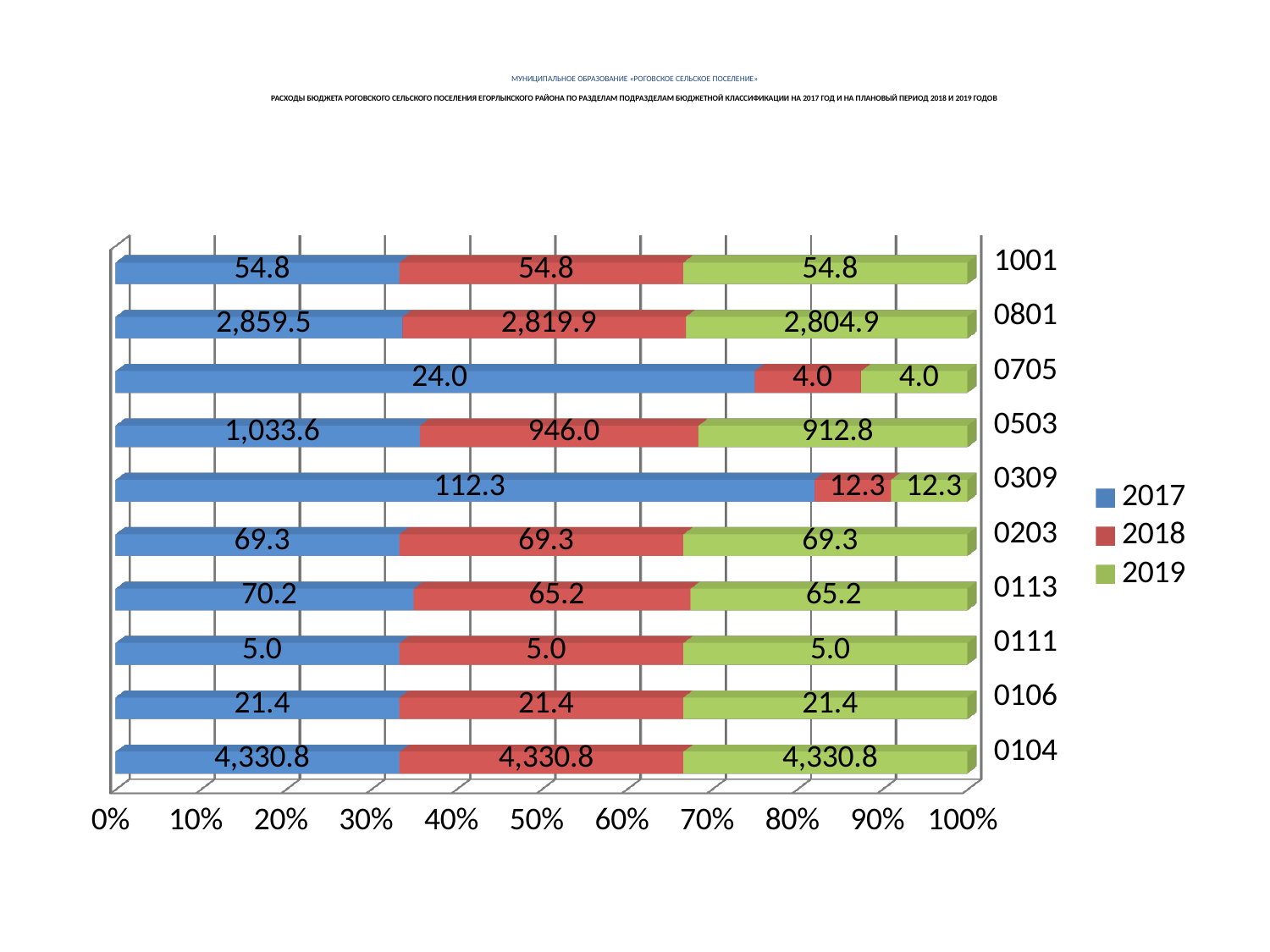
Which category has the lowest 2017 value? 0111 What is the difference between the 2017 and 2018 values for category 0503? 87.6 How many series does the legend list? 3 What is the 2019 value for category 0503? 912.8 What is the difference between the 2017 and 2018 values for category 0113? 5.0 Which category has the highest 2017 value? 0104 What kind of chart is shown on the slide? Stacked bar chart What is the 2018 value for category 0705? 4.0 What is the 2017 value for category 0309? 112.3 What is the 2017 value for category 0801? 2,859.5 How many categories are shown on the chart? 10 For category 0309, which is larger: the 2017 value or the 2018 value? 2017